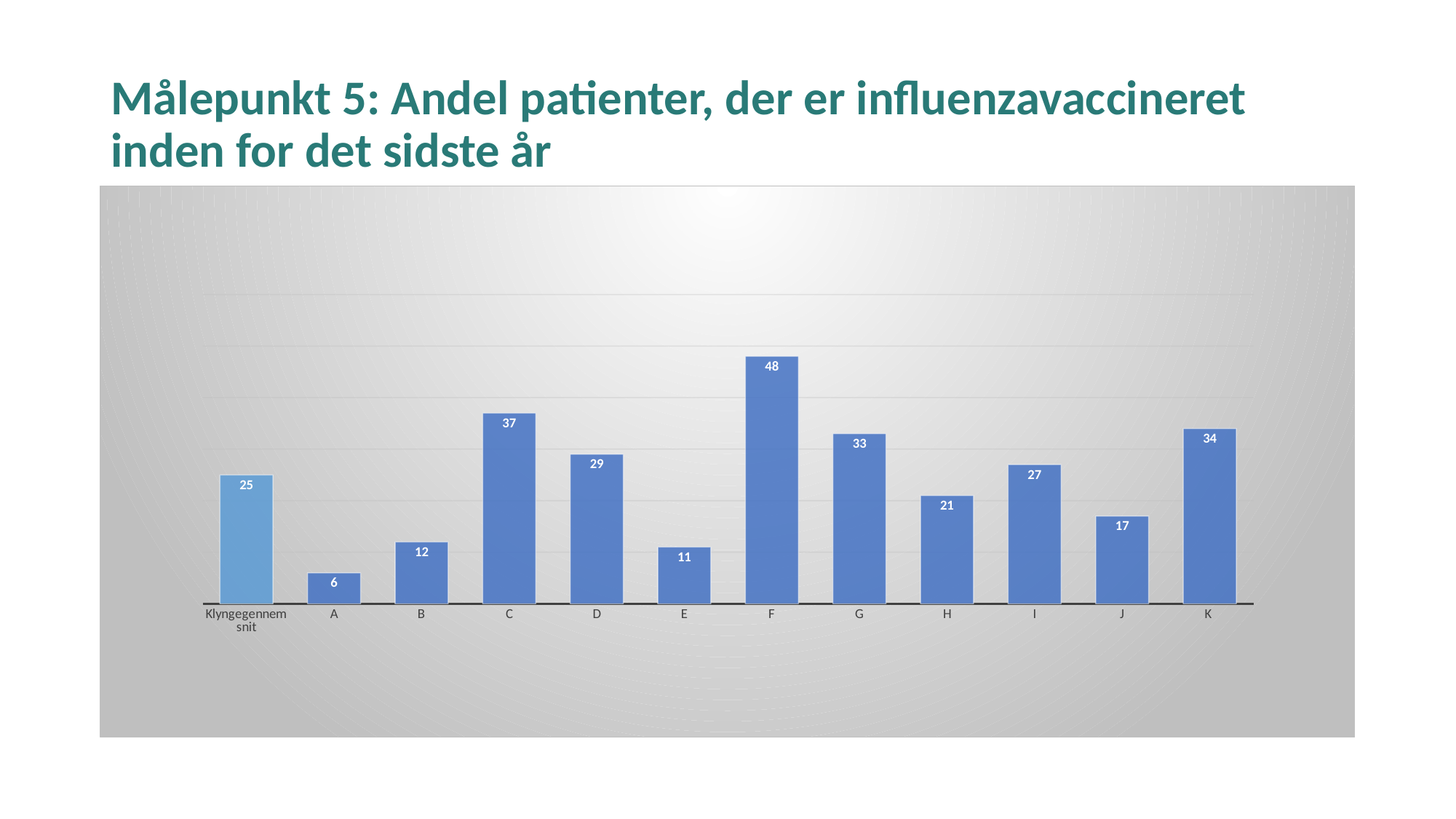
Which category has the lowest value? A Which is larger, the value for E or the value for J? J What is the value for Klyngegennemsnit? 25 What is the value for category H? 21 What is the value for category F? 48 How many categories are shown on the x axis? 12 Which category has the highest value? F Which is larger, the value for G or the value for D? G What is the difference between the values for C and B? 25 What is the difference between the values for K and Klyngegennemsnit? 9 What kind of chart is shown on the slide? Bar chart Which bar is shown in a lighter blue colour than the others? Klyngegennemsnit